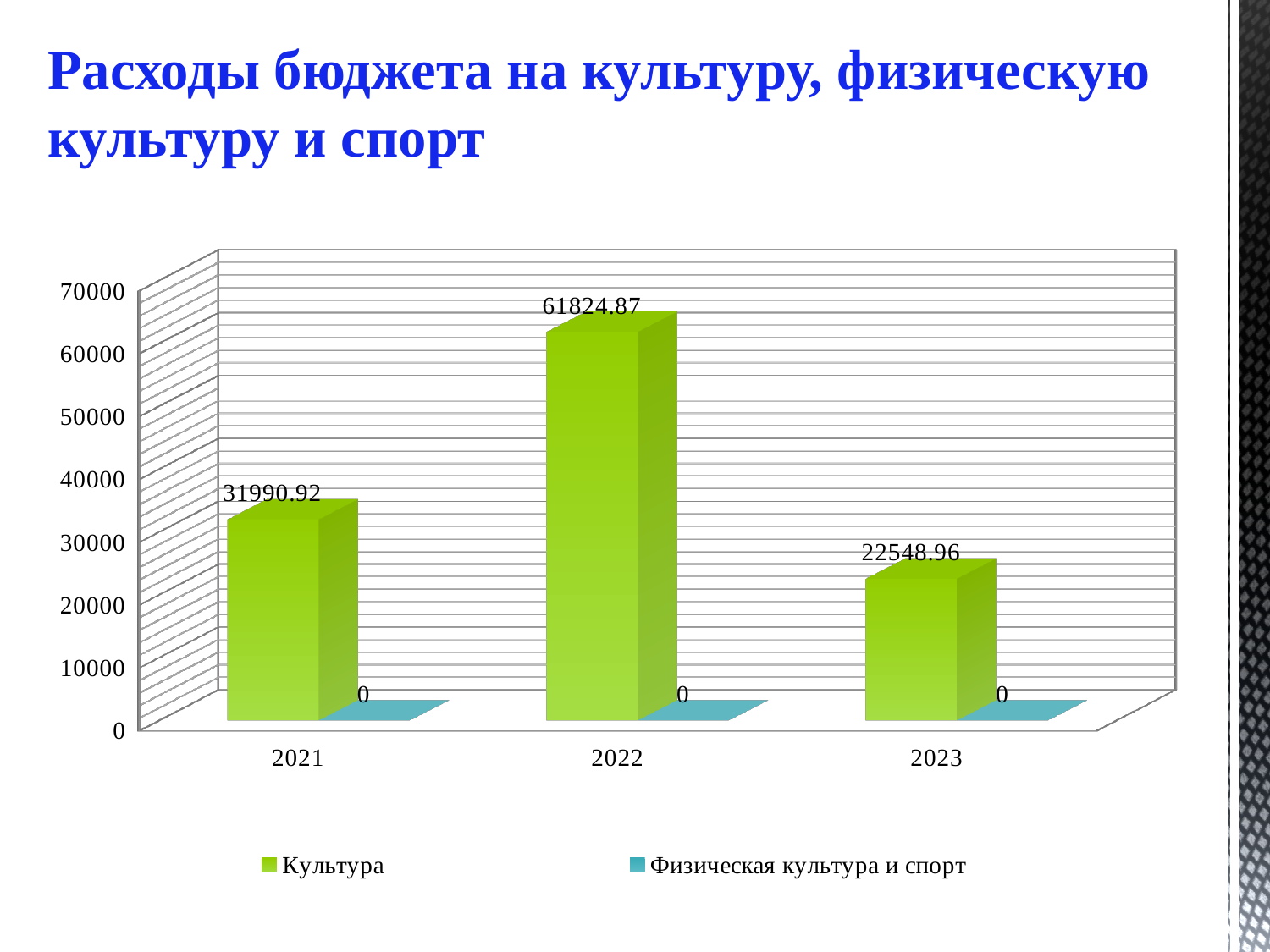
What kind of chart is shown on the slide? Bar chart What is the difference between the Культура values for 2022 and 2021? 29833.95 What is the difference between the Культура values for 2021 and 2023? 9441.96 What is the value for Культура in 2022? 61824.87 What is the value for Физическая культура и спорт in 2022? 0 What is the value for Культура in 2023? 22548.96 Which is larger, the Культура value for 2021 or for 2023? 2021 In which year is the value for Культура lowest? 2023 How many series does the legend list? 2 How many years are shown on the x axis? 3 In which year is the value for Культура highest? 2022 What is the value for Культура in 2021? 31990.92